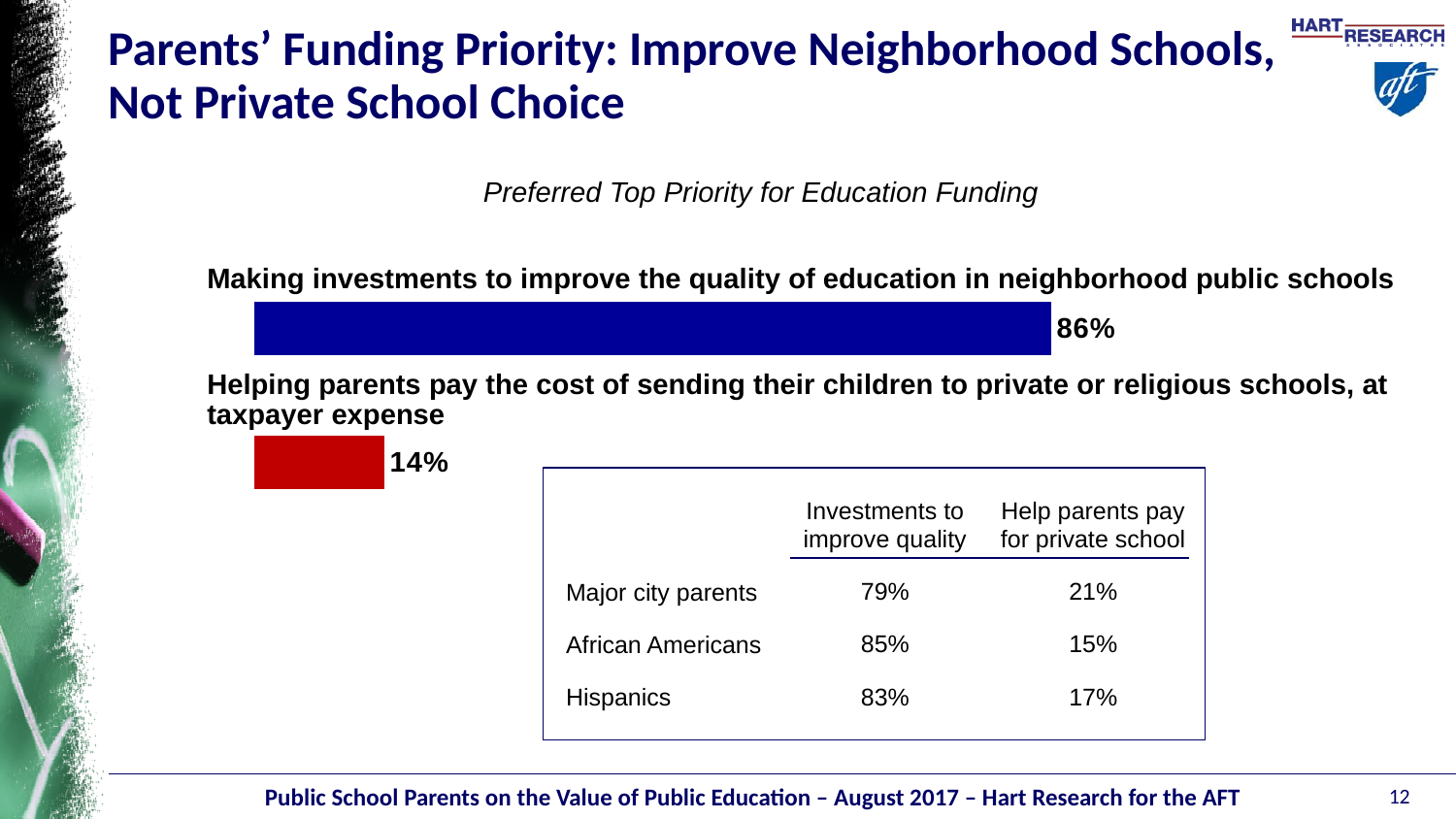
Which option has the lower bar in the chart? Helping parents pay the cost of sending their children to private or religious schools, at taxpayer expense What is the title of the chart? Preferred Top Priority for Education Funding What percentage of parents chose helping parents pay the cost of sending their children to private or religious schools as their top priority? 14% What type of chart is shown on the slide? bar chart How many bars are shown in the chart? 2 Which option has the higher bar in the chart? Making investments to improve the quality of education in neighborhood public schools What colour is the bar for helping parents pay for private or religious schools? red Do the two bars in the chart add up to 100%? yes Is the bar for improving neighborhood public schools larger or smaller than the bar for helping parents pay for private or religious schools? larger What is the difference in percentage points between the two bars in the chart? 72 What percentage of parents chose making investments to improve the quality of education in neighborhood public schools as their top priority? 86%